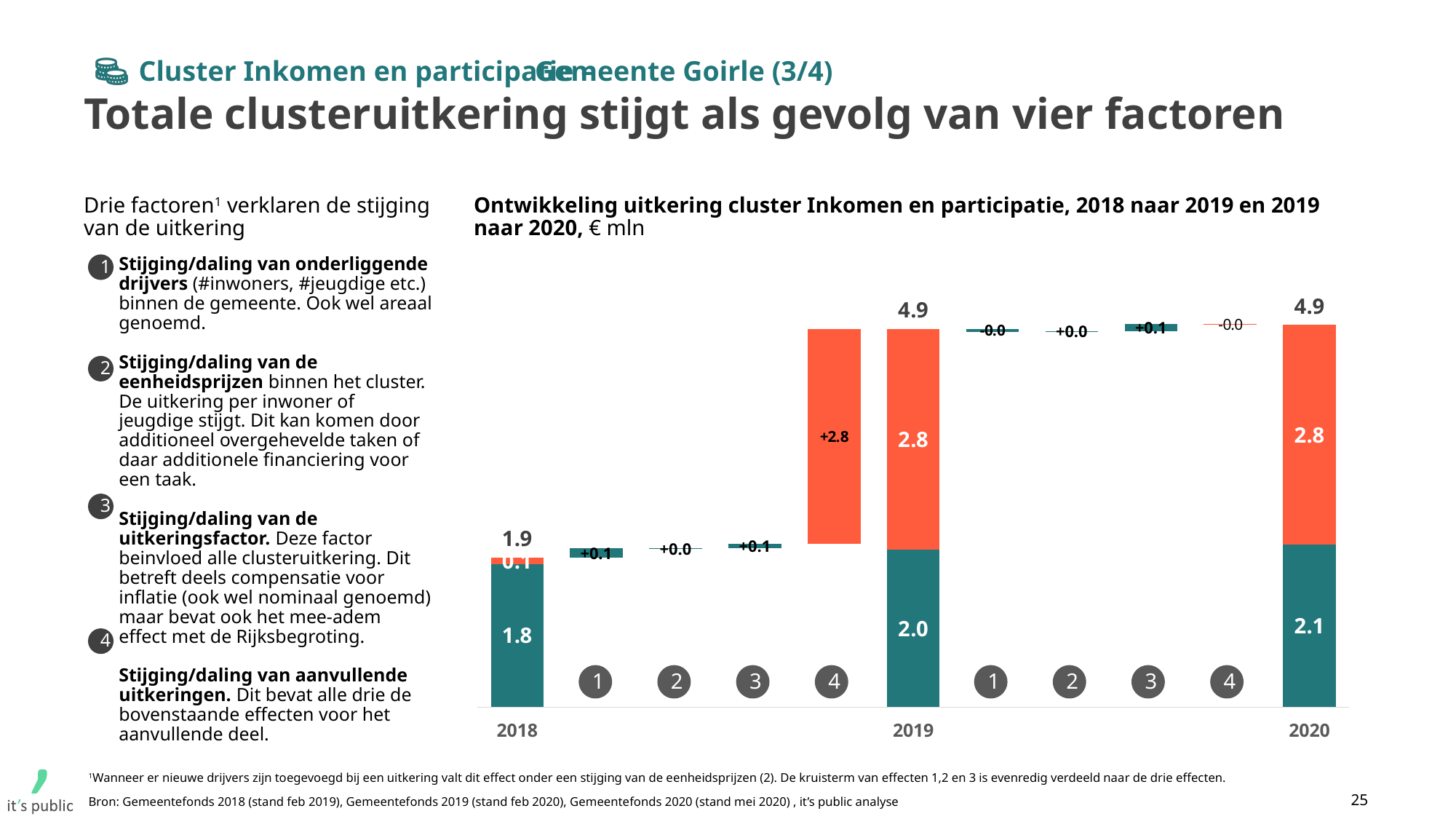
What is the total value shown above the 2019 bar? 4.9 What is the value of the step labelled 3 between 2019 and 2020? +0.1 What is the value of the teal (bottom) segment of the 2020 bar? 2.1 What is the value of the orange (top) segment of the 2019 bar? 2.8 How many year totals (full bars) are shown in the chart? 3 What unit is stated in the chart title? € mln Is the 2019 total larger or smaller than the 2018 total? larger What is the difference between the 2019 total and the 2018 total? 3.0 What is the total value shown above the 2018 bar? 1.9 Which of the four steps between 2018 and 2019 has the largest value? 4 What kind of chart is shown on the slide? bar chart (waterfall) What is the value of the step labelled 4 between 2018 and 2019? +2.8